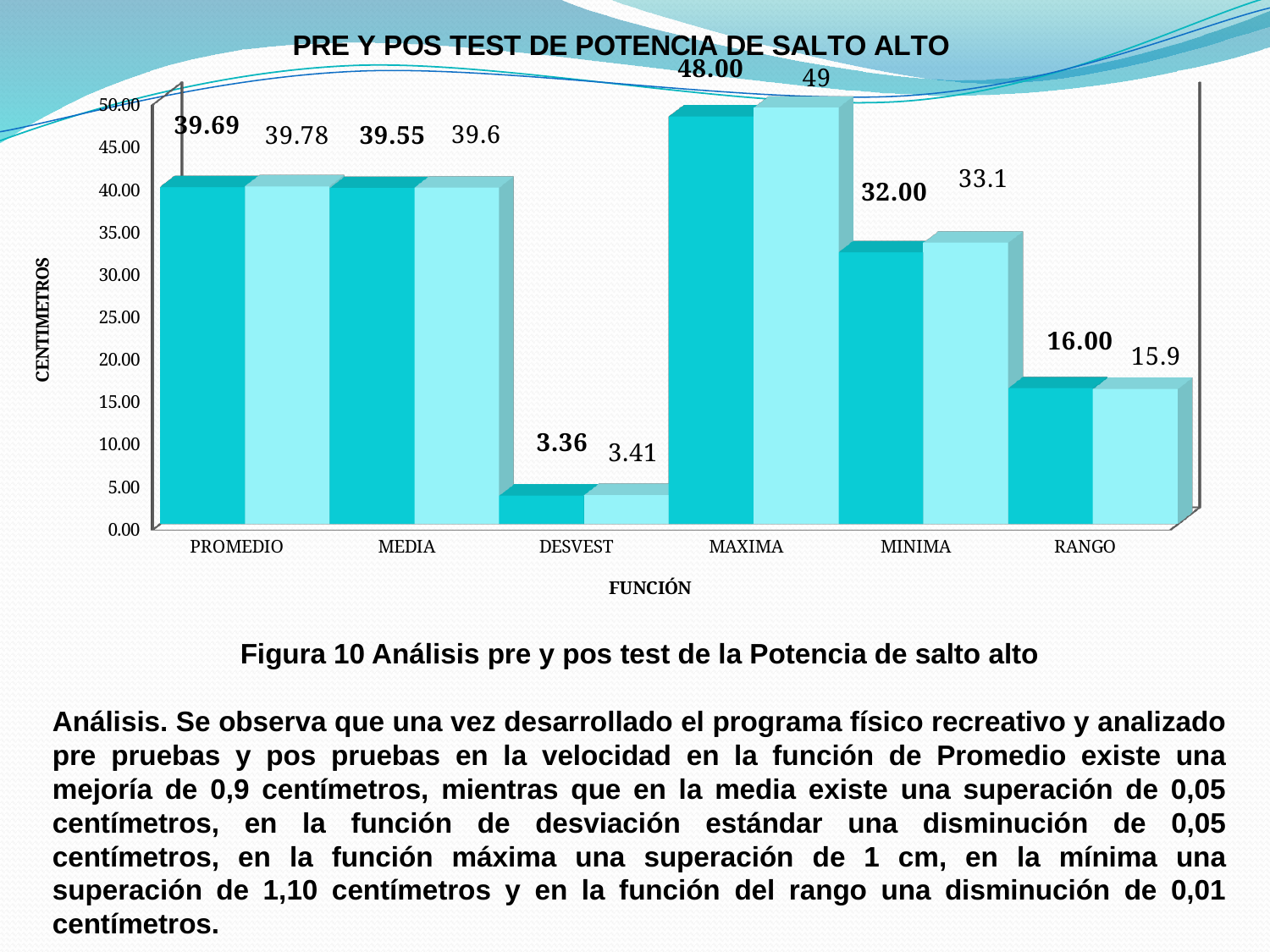
What is the title of the chart? PRE Y POS TEST DE POTENCIA DE SALTO ALTO What is the value of the first (left, darker) bar for MAXIMA? 48.00 How many categories are shown on the x axis of the chart? 6 Which category has the lowest bars in the chart? DESVEST For RANGO, which bar is larger: the first (16.00) or the second (15.9)? the first (16.00) What is the value of the first (left, darker) bar for DESVEST? 3.36 Which category has the highest bars in the chart? MAXIMA What is the difference between the two bars for MAXIMA (49 and 48.00)? 1 What is the value of the second (right, lighter) bar for PROMEDIO? 39.78 What is the value of the second (right, lighter) bar for MINIMA? 33.1 What kind of chart is shown on the slide? bar chart What is the difference between the two bars for MINIMA (33.1 and 32.00)? 1.1